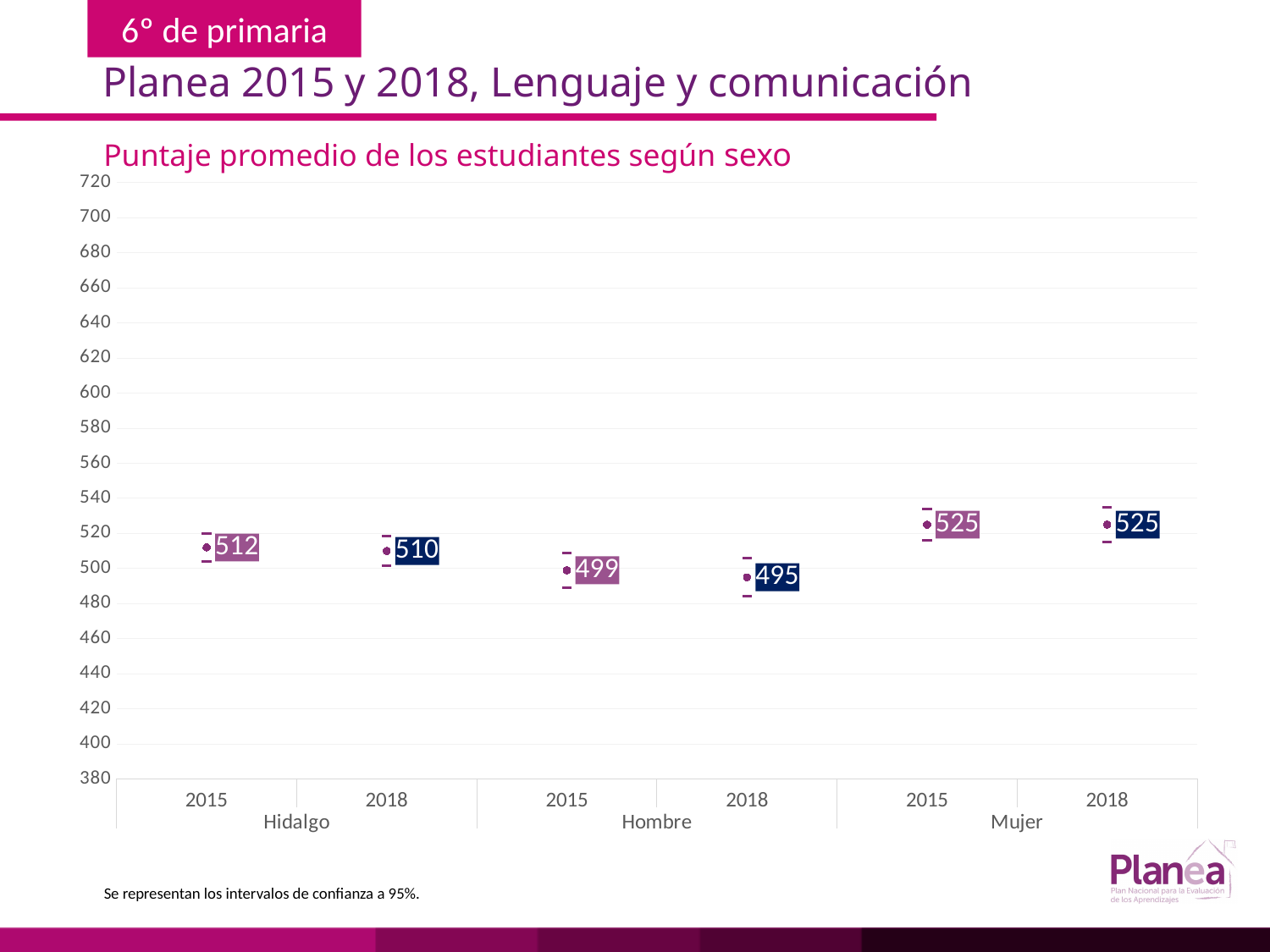
What is the difference between the Hidalgo 2015 score and the Hidalgo 2018 score? 2 What is the average score for Mujer in 2018? 525 What is the average score for Hombre in 2018? 495 How many data points are plotted on the chart? 6 Which is larger, the Hombre 2015 score or the Hidalgo 2018 score? Hidalgo 2018 What is the average score for Hidalgo in 2018? 510 Is the value for Mujer in 2015 greater or less than 520? greater What is the difference between the Mujer 2015 score and the Hombre 2015 score? 26 What is the average score for Hidalgo in 2015? 512 Which group and year has the lowest average score? Hombre 2018 Did the Hombre score rise or fall from 2015 to 2018? fall What is the title of the chart? Puntaje promedio de los estudiantes según sexo